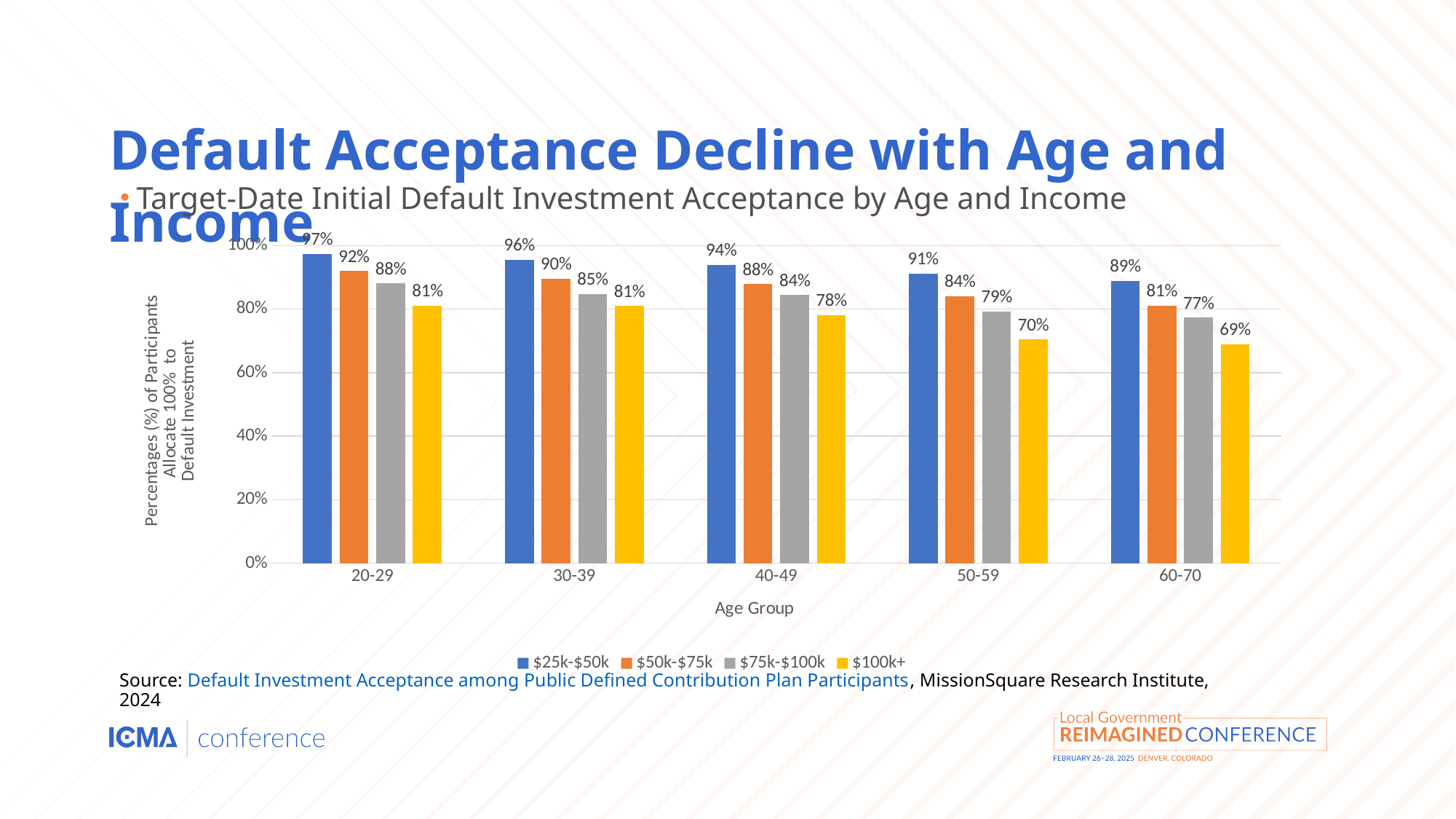
Which age group has the highest value for the $25k-$50k series? 20-29 What kind of chart is shown on the slide? Bar chart Do the values for the $25k-$50k series rise or fall as age group increases along the x axis? Fall How many age groups are shown on the x axis? 5 What is the difference between the $25k-$50k and $100k+ values in the 50-59 age group? 21 percentage points What is the value for the $50k-$75k series in the 50-59 age group? 84% What is the value for the $100k+ series in the 60-70 age group? 69% What is the value for the $25k-$50k series in the 20-29 age group? 97% How many series does the legend list? 4 Which age group has the lowest value for the $100k+ series? 60-70 What is the value for the $75k-$100k series in the 40-49 age group? 84% Which is larger in the 30-39 age group: the $50k-$75k value or the $75k-$100k value? $50k-$75k